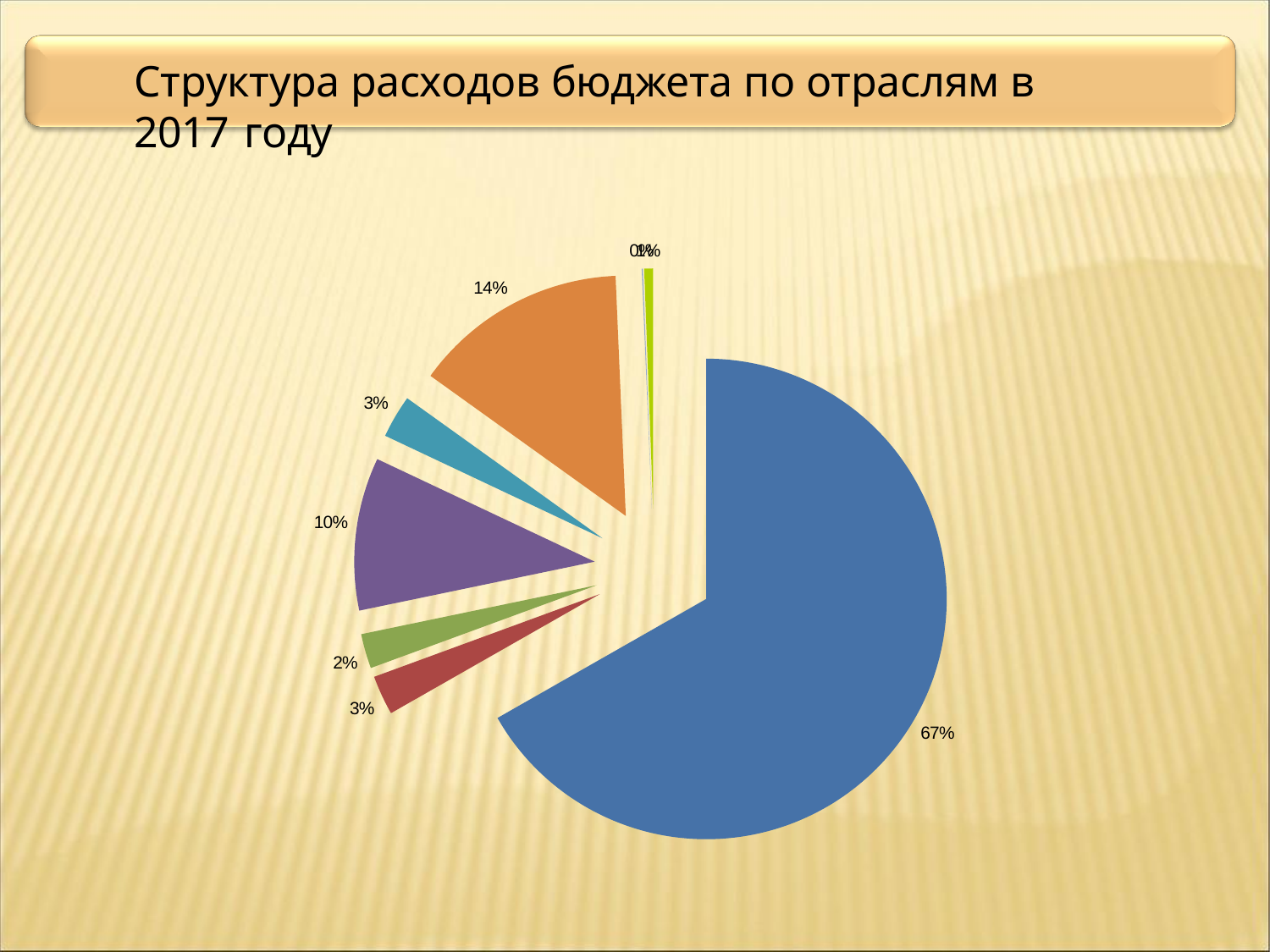
What percentage is shown for the largest slice of the pie? 67% What is the second-largest percentage shown on the pie? 14% What percentage is shown for the green slice next to the red slice? 2% What is the difference in percentage points between the blue slice (67%) and the orange slice (14%)? 53 Does the chart have a legend identifying the slices? no Which slice is larger, the orange slice or the purple slice? the orange slice What percentage is shown for the orange slice? 14% What percentage is shown for the large blue slice? 67% Is the share of the blue slice greater or less than 50%? greater What is the title of the chart on the slide? Структура расходов бюджета по отраслям в 2017 году What percentage is shown for the purple slice? 10% What kind of chart is shown on the slide? pie chart